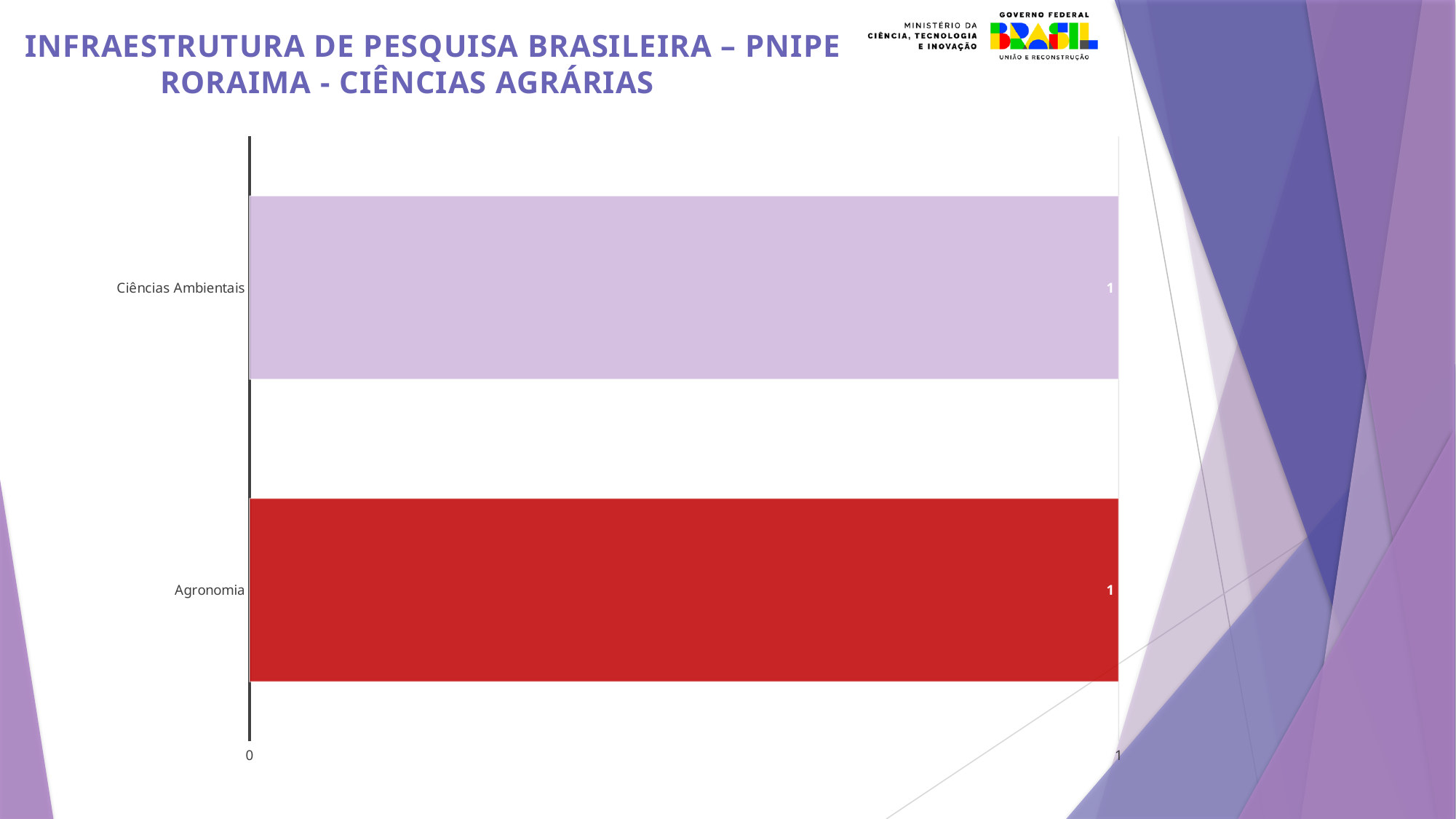
What is the value for Agronomia? 1 Which category is shown at the top of the chart? Ciências Ambientais What is the total of the values for Ciências Ambientais and Agronomia? 2 What is the difference between the values for Ciências Ambientais and Agronomia? 0 What is the highest value shown on the horizontal axis? 1 What kind of chart is shown on the slide? Bar chart How many categories are shown in the chart? 2 What colour is the bar for Agronomia? Red What is the value for Ciências Ambientais? 1